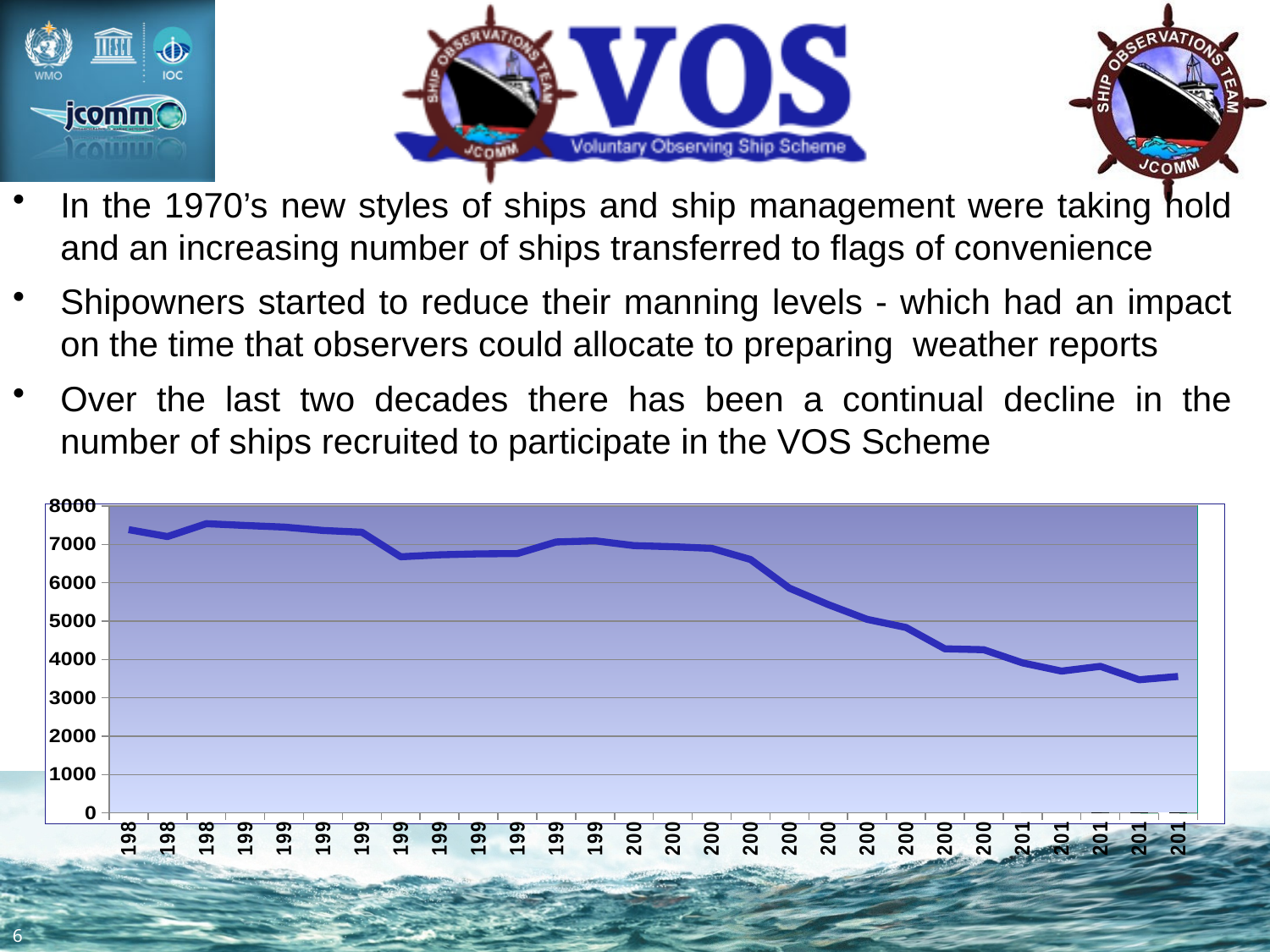
Which is larger, the value at the leftmost point of the line or the value at the rightmost point? the leftmost point Do the values in the line chart generally rise or fall from left to right along the x axis? fall What is the interval between consecutive tick marks on the y axis? 1000 Is the lowest point of the line greater or less than 3000? greater What is the highest value shown on the y axis of the chart? 8000 Is the value at the last (rightmost) point of the line greater or less than 3000? greater Is the value at the last (rightmost) point of the line greater or less than 4000? less How many data points are plotted along the x axis of the line chart? 28 What kind of chart is shown on the slide? line chart